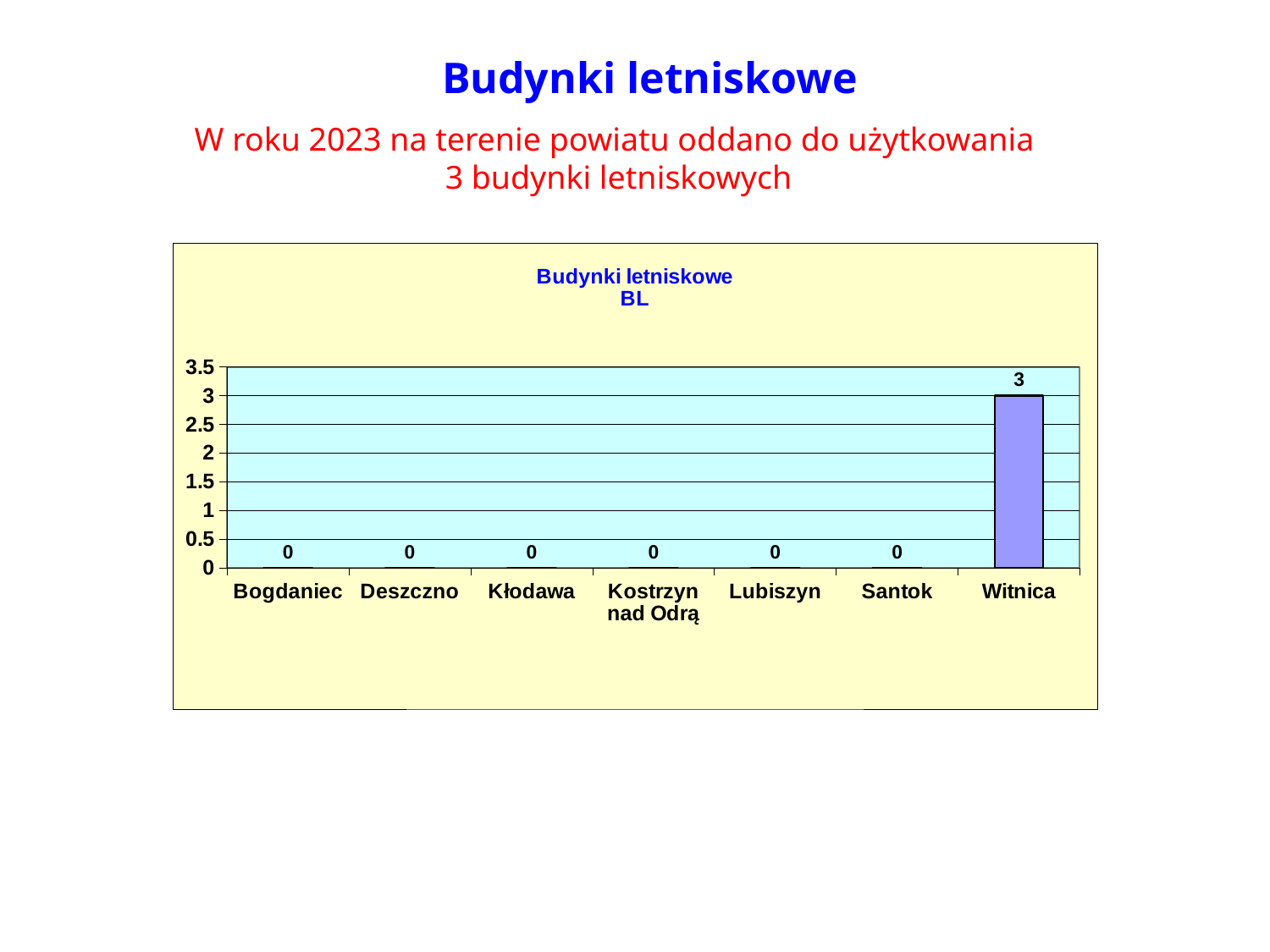
How many categories have a value of 0? 6 Is the value for Witnica greater or less than 2? greater What is the value for Bogdaniec? 0 Which is larger, the value for Witnica or the value for Lubiszyn? Witnica What is the title of the chart? Budynki letniskowe BL How many categories are shown on the x axis? 7 What is the difference between the values for Witnica and Santok? 3 Which category has the highest value? Witnica What kind of chart is shown? bar chart What is the value for Kostrzyn nad Odrą? 0 What is the total of all values shown in the chart? 3 What is the value for Witnica? 3